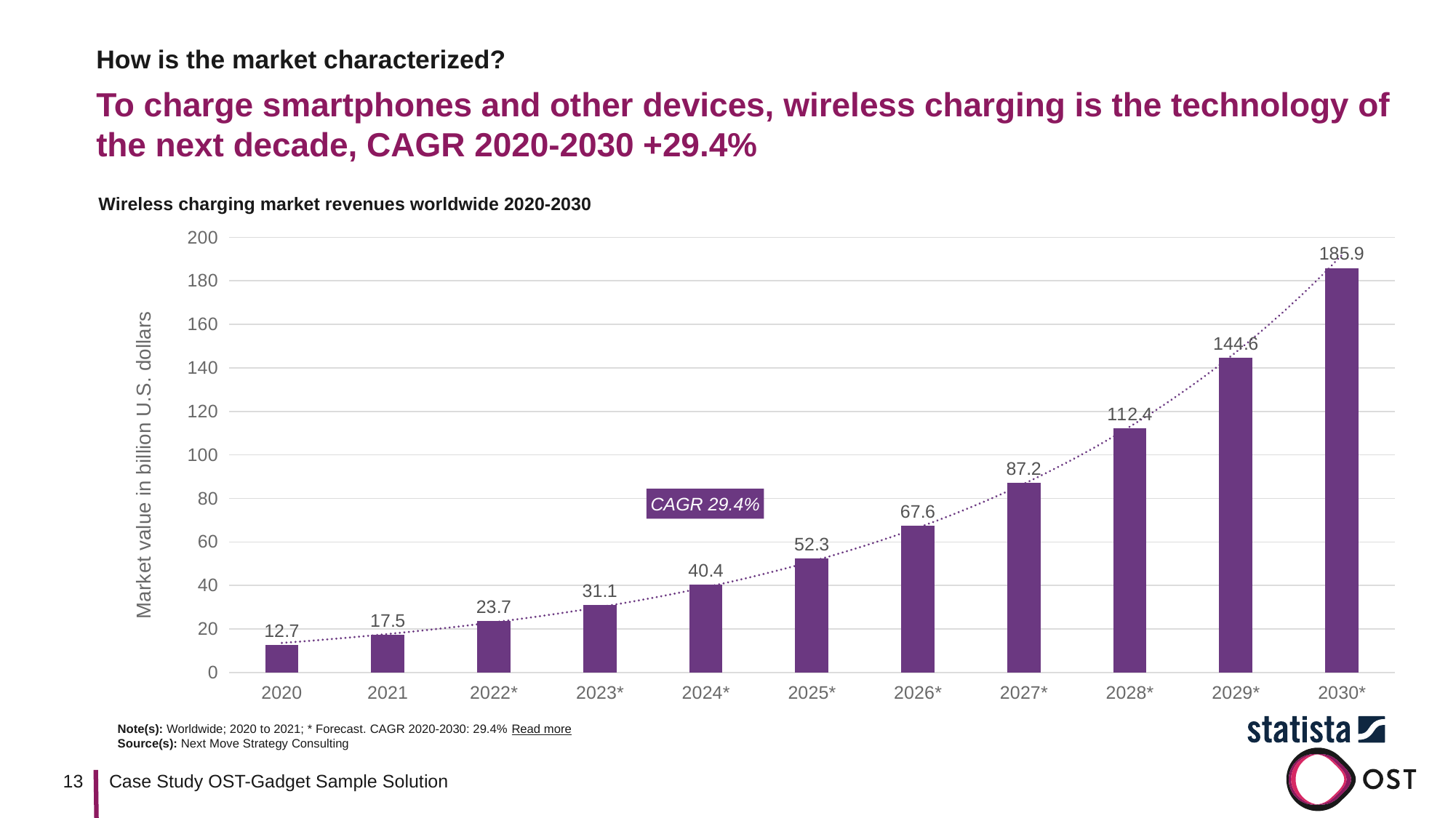
How many years are shown on the x axis? 11 Do the market values rise or fall from 2020 to 2030*? rise Is the value for 2029* greater or less than 140? greater Which year has the highest market value? 2030* What is the market value for 2025*? 52.3 What kind of chart is this? bar chart What is the market value for 2020? 12.7 What is the difference between the market values for 2030* and 2029*? 41.3 What is the market value for 2028*? 112.4 What is the difference between the market values for 2021 and 2020? 4.8 Which year has the lowest market value? 2020 Which is larger, the market value for 2026* or for 2027*? 2027*